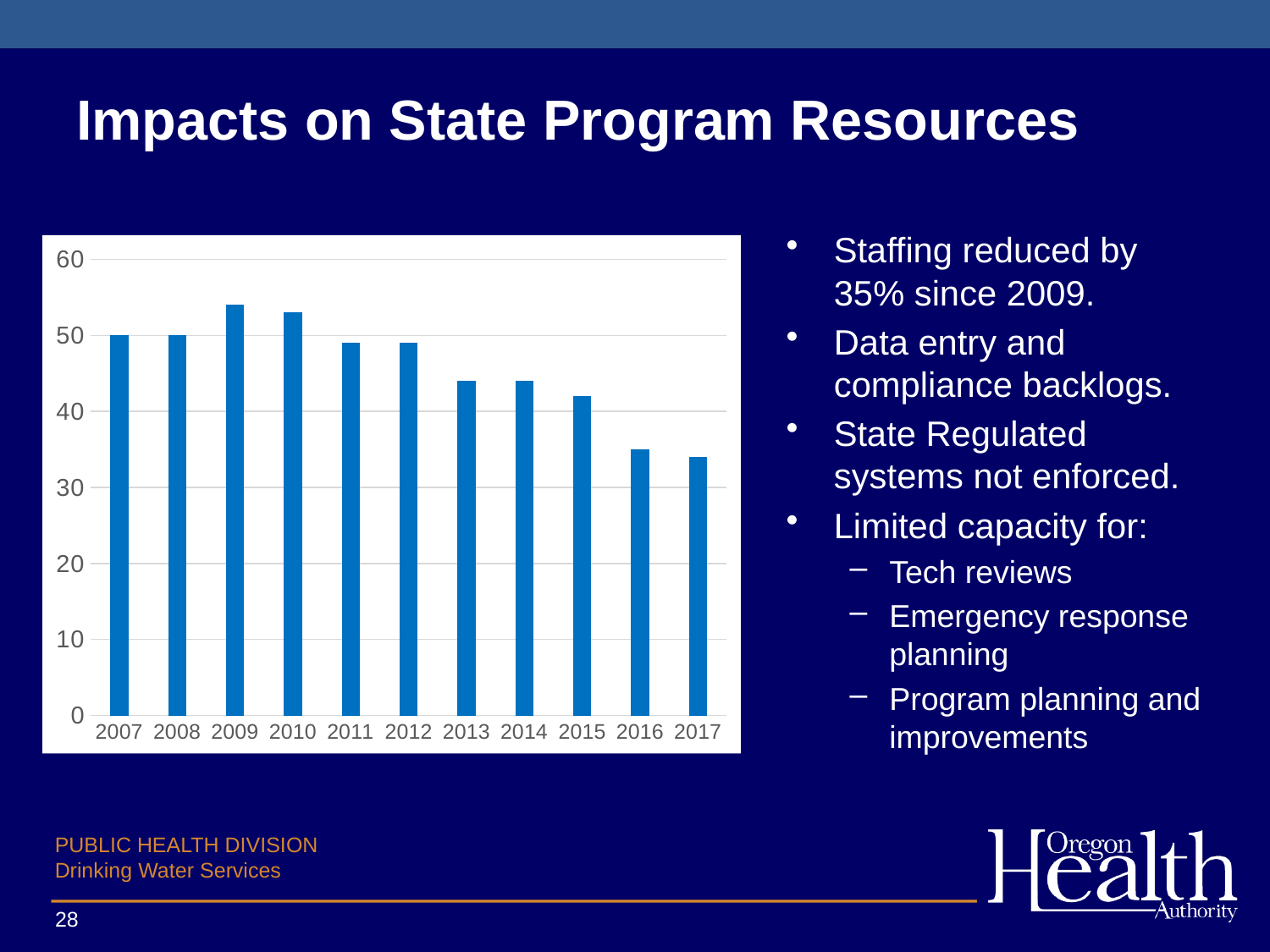
Is the value for 2016 greater or less than 40? less Which is larger, the value for 2007 or the value for 2015? 2007 Is the value for 2017 greater or less than 40? less Which is larger, the value for 2009 or the value for 2016? 2009 Which year has the highest bar in the chart? 2009 What colour are the bars in the chart? blue Do the values generally rise or fall from 2007 to 2017? fall How many years are shown on the x axis of the chart? 11 Is the value for 2009 greater or less than 50? greater What kind of chart is shown on the slide? bar chart